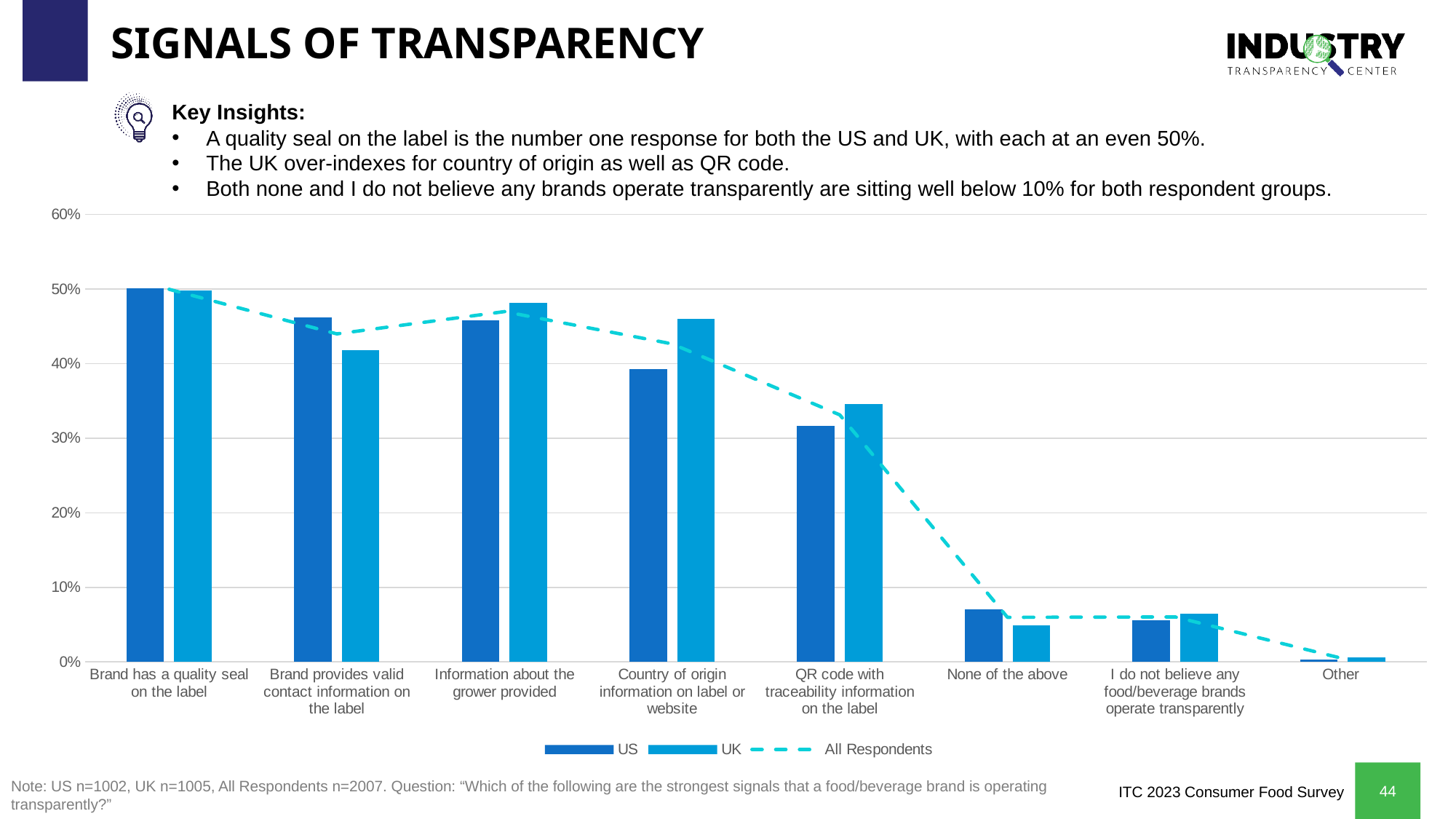
For 'Brand provides valid contact information on the label', which is larger, the US value or the UK value? US Which category has the lowest UK value? Other For 'Country of origin information on label or website', which is larger, the US value or the UK value? UK What type of chart is shown on the slide? combination bar and line chart Is the UK value for 'Brand provides valid contact information on the label' greater or less than 40%? greater Is the US value for 'Country of origin information on label or website' greater or less than 40%? less What is the US value for 'Brand has a quality seal on the label'? 50% How many categories are shown on the x axis of the chart? 8 Do the All Respondents values generally rise or fall from left to right across the categories? fall Which category has the highest US value? Brand has a quality seal on the label Is the US value for 'None of the above' greater or less than 10%? less How many series does the chart legend list? 3